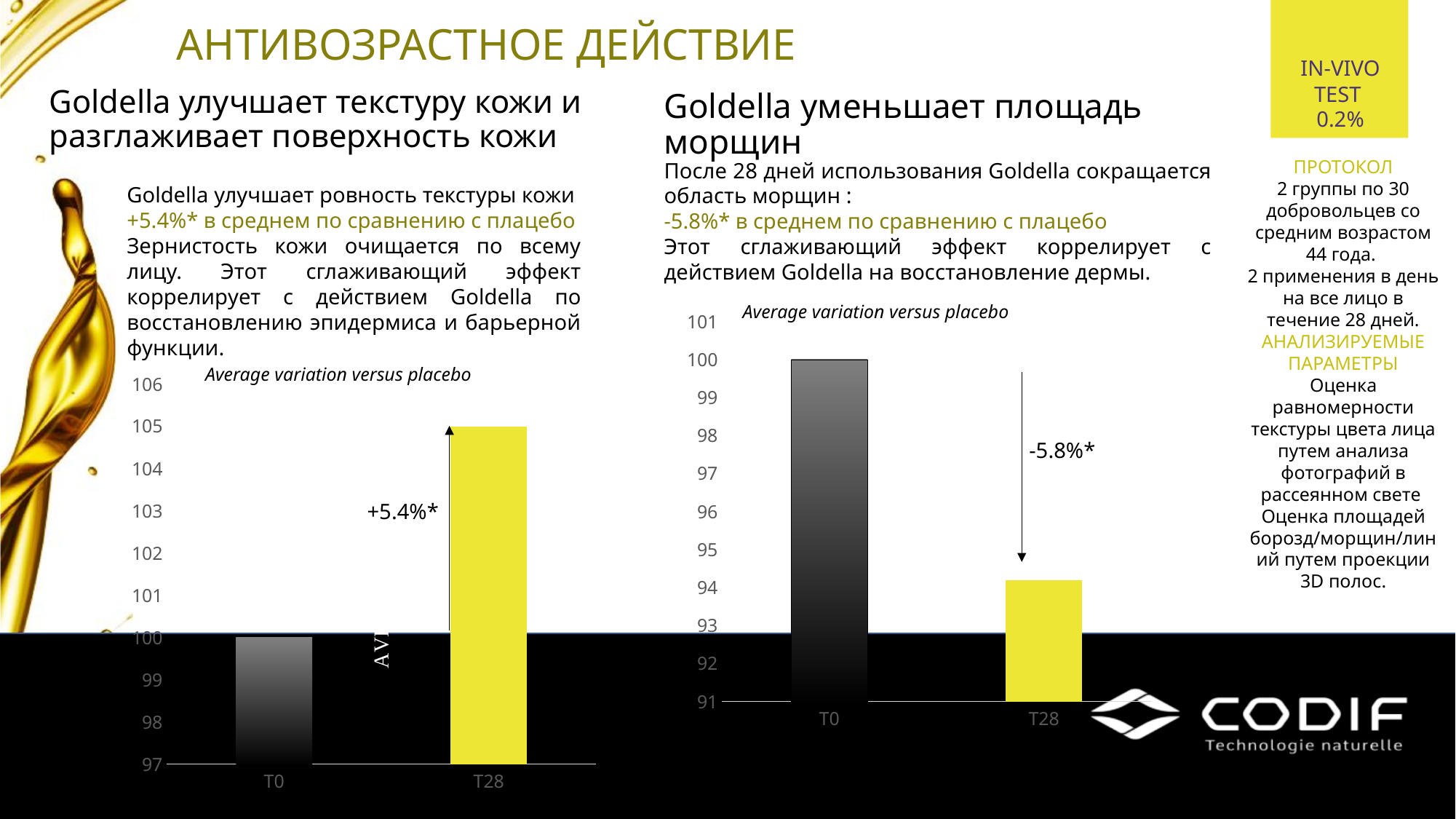
What kind of chart is the left chart (Average variation versus placebo, under the skin texture text)? bar chart What is the title printed above the right chart? Average variation versus placebo In the right chart, what percentage change is printed next to the arrow? -5.8%* In the left chart, which category has the higher bar? T28 In the right chart, which category has the lower bar? T28 How many categories are shown on the x axis of the left chart? 2 In the left chart, do the values rise or fall from T0 to T28? rise In the left chart, what is the value for T0? 100 In the right chart, is the value for T28 greater or less than 95? less In the right chart, what is the value for T0? 100 In the left chart, what percentage change is printed next to the arrow? +5.4%* In the left chart, what is the value for T28? 105